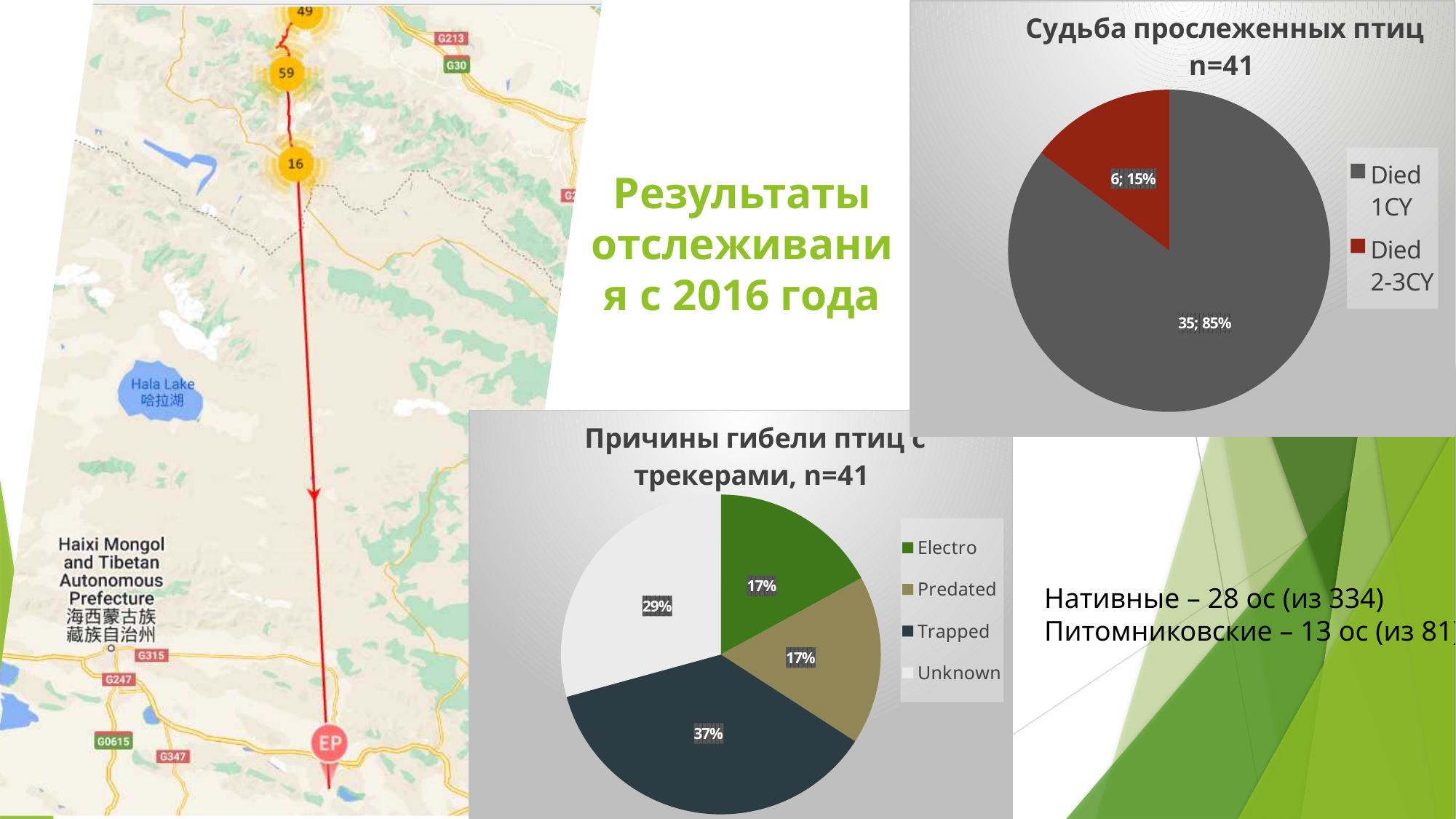
In the chart titled "Причины гибели птиц с трекерами, n=41", how many categories does the legend list? 4 In the chart titled "Судьба прослеженных птиц n=41", how many birds are in the "Died 2-3CY" slice? 6 In the chart titled "Судьба прослеженных птиц n=41", how many categories does the legend list? 2 In the chart titled "Причины гибели птиц с трекерами, n=41", which cause has the largest share? Trapped In the chart titled "Причины гибели птиц с трекерами, n=41", which is larger: the share for "Unknown" or the share for "Electro"? Unknown In the chart titled "Судьба прослеженных птиц n=41", what is the difference in count between "Died 1CY" and "Died 2-3CY"? 29 In the chart titled "Причины гибели птиц с трекерами, n=41", what share is labelled "Trapped"? 37% What kind of chart is the one titled "Причины гибели птиц с трекерами, n=41"? Pie chart In the chart titled "Судьба прослеженных птиц n=41", which category has the largest slice? Died 1CY In the chart titled "Причины гибели птиц с трекерами, n=41", what share is labelled "Unknown"? 29% In the chart titled "Судьба прослеженных птиц n=41", what percentage of birds is labelled "Died 1CY"? 85% In the chart titled "Причины гибели птиц с трекерами, n=41", what colour is the "Electro" slice? Green